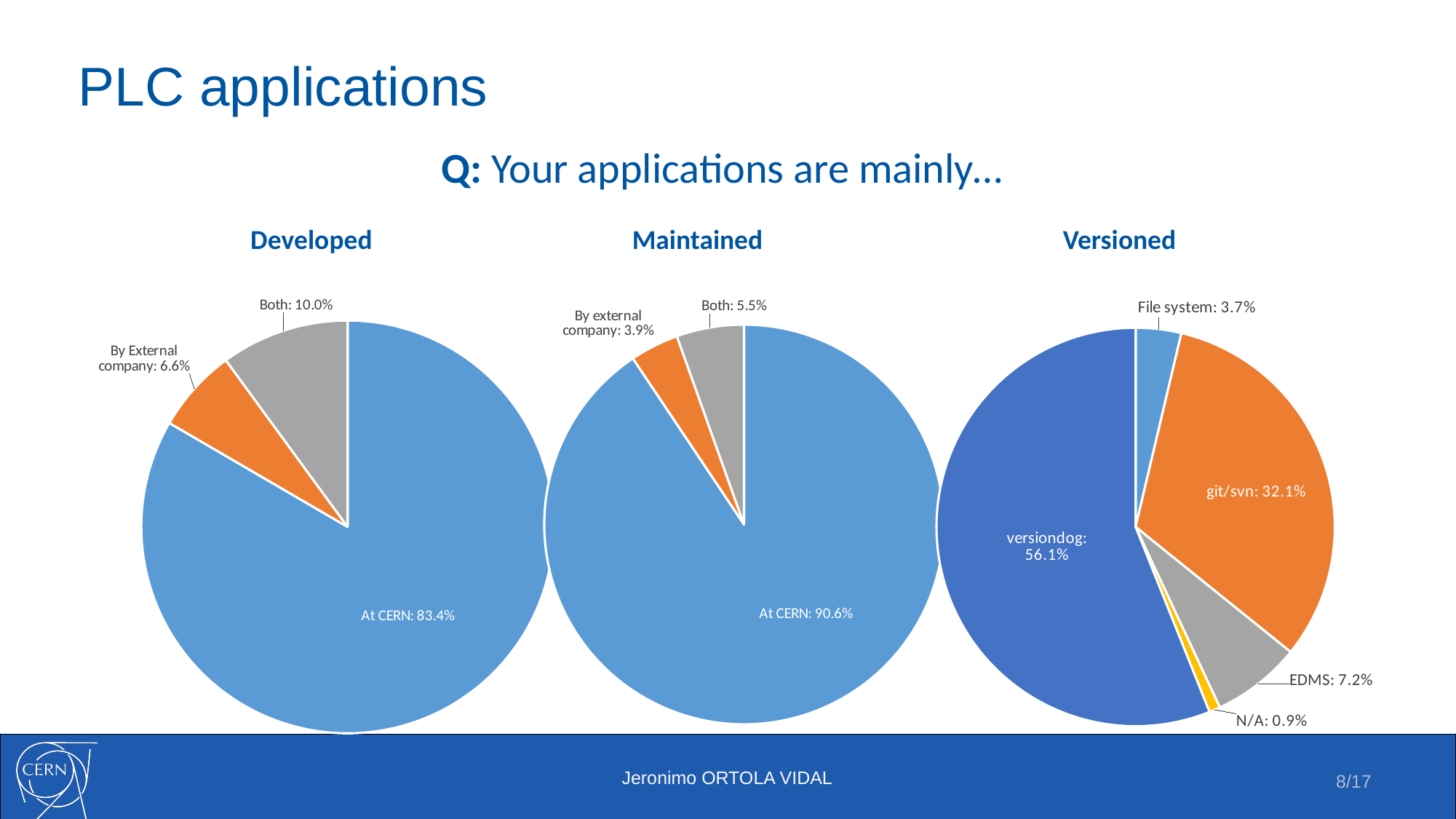
What kind of chart is used for the Developed, Maintained and Versioned data? Pie chart What is the title of the chart on the right of the slide? Versioned In the Developed pie chart, what is the difference between the Both share and the By External company share? 3.4% In the Versioned pie chart, which category has the largest slice? versiondog In the Developed pie chart, what share is labelled for At CERN? 83.4% How many slices does the Maintained pie chart have? 3 How many slices does the Versioned pie chart have? 5 Which is larger: the At CERN share in the Developed chart or the At CERN share in the Maintained chart? Maintained In the Versioned pie chart, which category has the smallest slice? N/A In the Maintained pie chart, what share is labelled for Both? 5.5% In the Versioned pie chart, what share is labelled for git/svn? 32.1% In the Developed pie chart, what share is labelled for By External company? 6.6%